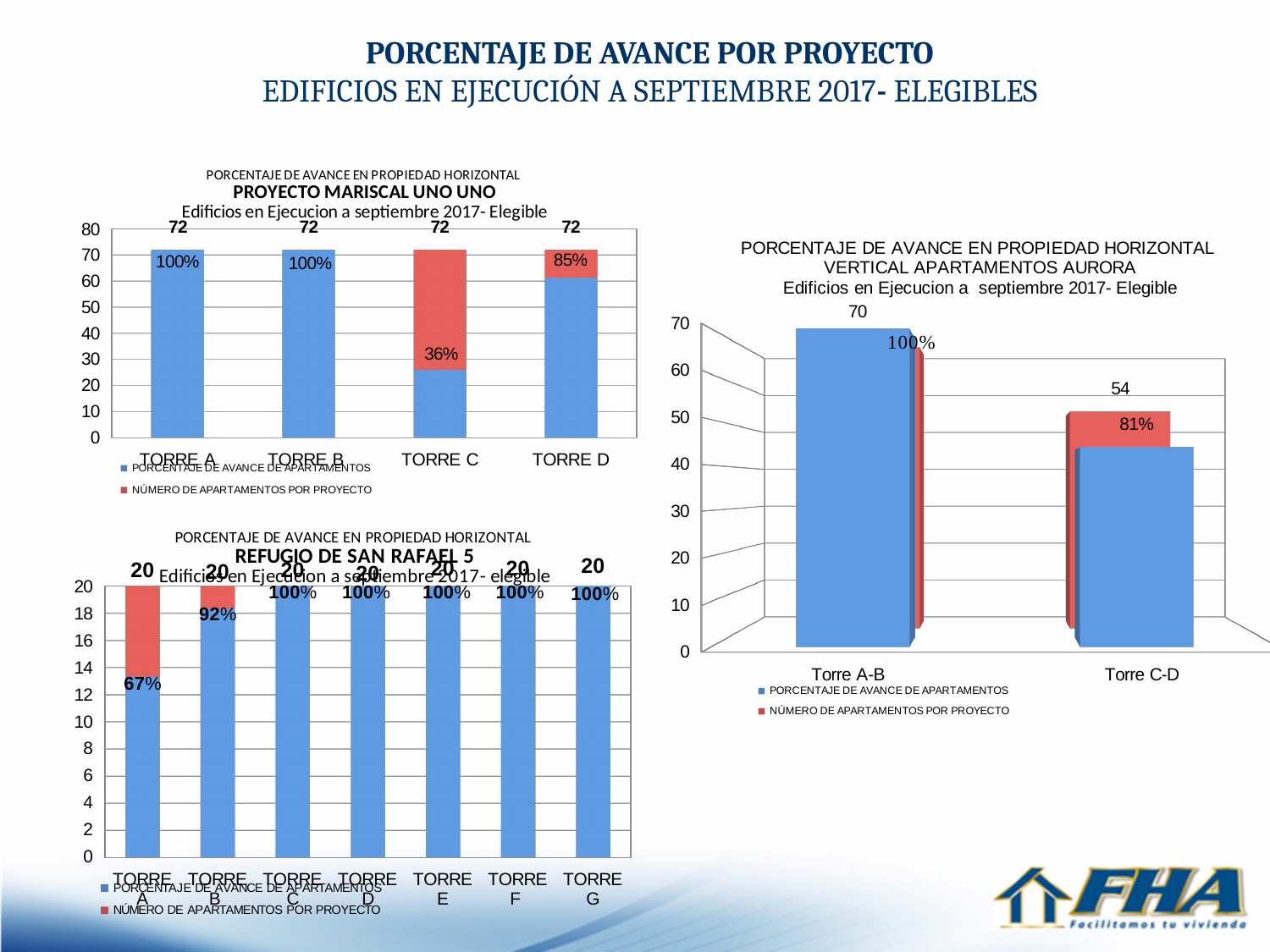
In the VERTICAL APARTAMENTOS AURORA chart, what is the difference between the number of apartments for Torre A-B and Torre C-D? 16 In the PROYECTO MARISCAL UNO UNO chart, which torre has the lowest percentage of progress? TORRE C In the VERTICAL APARTAMENTOS AURORA chart, what percentage of progress is shown for Torre A-B? 100% How many torres are shown in the PROYECTO MARISCAL UNO UNO chart? 4 In the REFUGIO DE SAN RAFAEL 5 chart, which torre has the lowest percentage of progress? TORRE A In the PROYECTO MARISCAL UNO UNO chart, what percentage of progress is shown for TORRE C? 36% How many torres are shown in the REFUGIO DE SAN RAFAEL 5 chart? 7 How many series does the legend of the PROYECTO MARISCAL UNO UNO chart list? 2 In the REFUGIO DE SAN RAFAEL 5 chart, what percentage of progress is shown for TORRE A? 67% In the PROYECTO MARISCAL UNO UNO chart, what percentage of progress is shown for TORRE D? 85% In the VERTICAL APARTAMENTOS AURORA chart, what is the number of apartments labelled for Torre C-D? 54 In the REFUGIO DE SAN RAFAEL 5 chart, what percentage of progress is shown for TORRE B? 92%